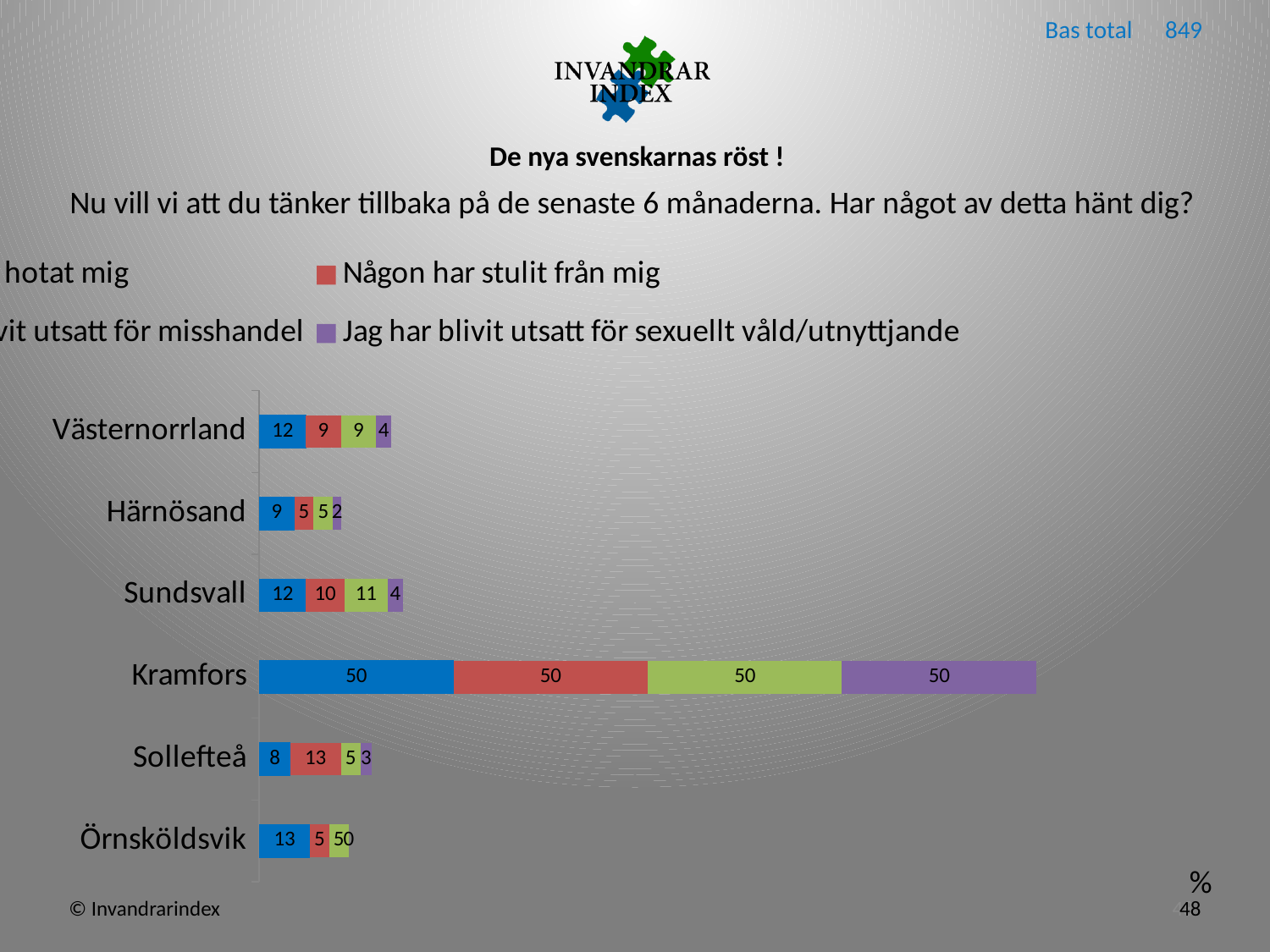
How many categories (regions) are shown on the chart? 6 Which region has the highest value for 'Jag har blivit utsatt för sexuellt våld/utnyttjande'? Kramfors What is the value for Örnsköldsvik in the series 'Jag har blivit utsatt för sexuellt våld/utnyttjande'? 0 How many series does the legend list? 4 What is the total of the stacked bar for Västernorrland? 34 Which is larger for 'Någon har stulit från mig': Sundsvall or Härnösand? Sundsvall What kind of chart is shown on the slide? Stacked bar chart What is the total of the stacked bar for Kramfors? 200 What is the difference between Sollefteå and Örnsköldsvik in the series 'Någon har stulit från mig'? 8 What is the value of the green segment for Sundsvall? 11 What is the value for Kramfors in the series 'Någon har stulit från mig'? 50 What is the value for Sollefteå in the series 'Någon har stulit från mig'? 13